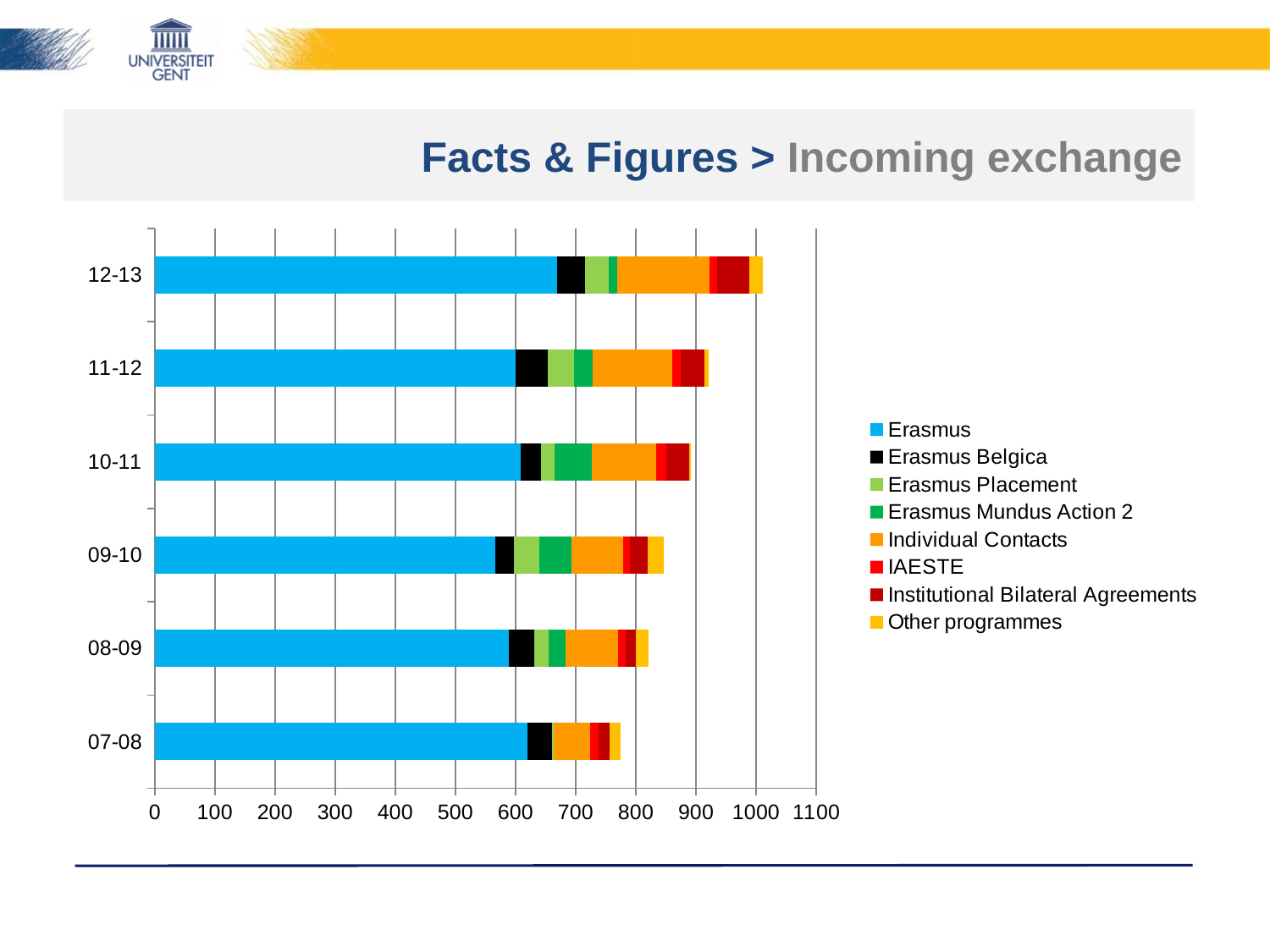
How many series does the legend list? 8 Is the total value for 09-10 greater or less than 800? greater Is the total value for 12-13 greater or less than 900? greater What kind of chart is shown on the slide? Stacked bar chart Is the Erasmus value for 09-10 greater or less than 600? less How many academic years (categories) are plotted on the chart? 6 Which has the larger total, 12-13 or 07-08? 12-13 Which academic year has the lowest total incoming exchange? 07-08 Which academic year has the highest total incoming exchange? 12-13 Which series is listed first in the legend? Erasmus Do the total values generally rise or fall from 07-08 to 12-13? rise